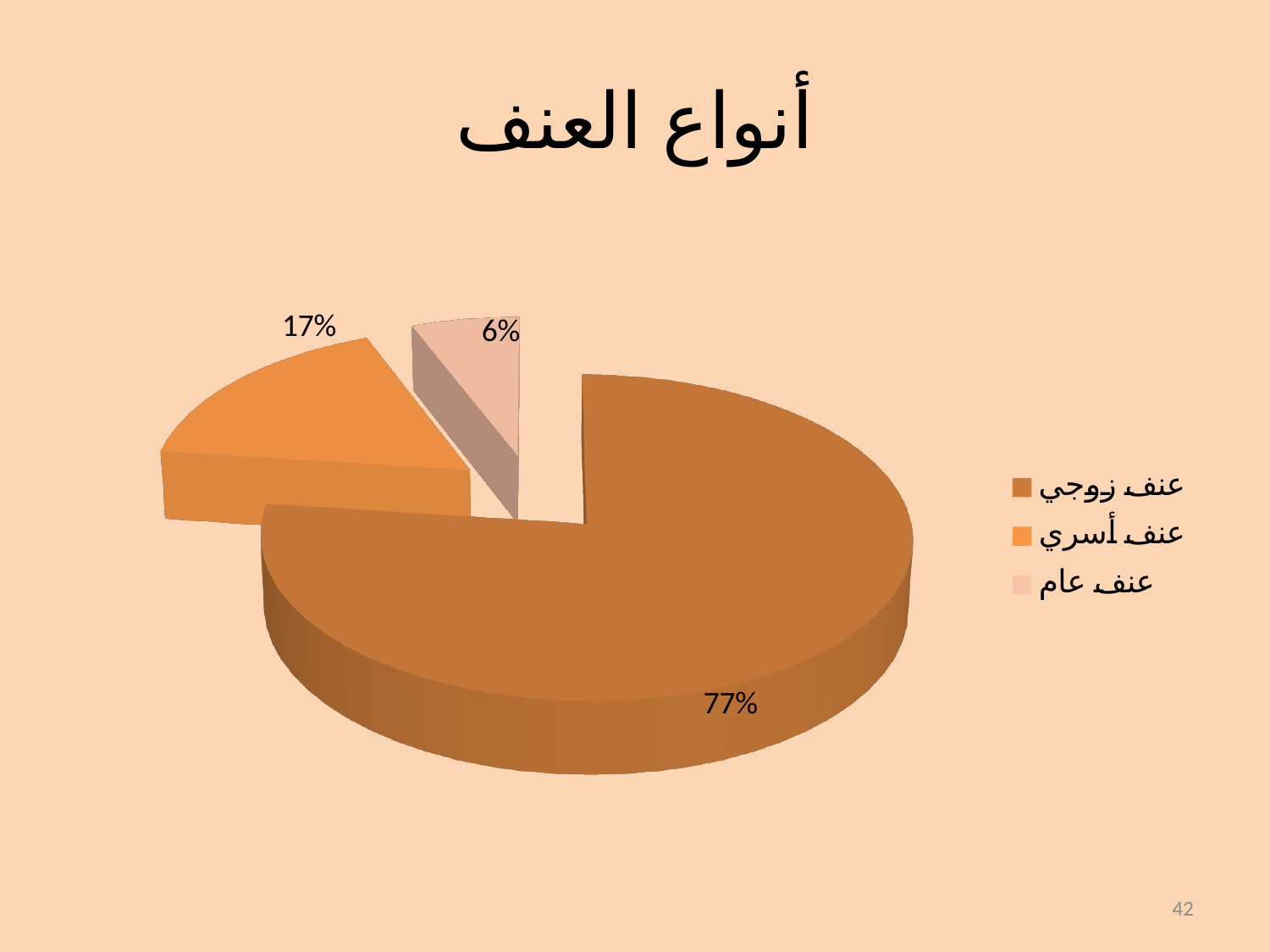
What percentage of the pie is عنف زوجي? 77% How many entries does the legend list? 3 What percentage of the pie is عنف عام? 6% What type of chart is shown on the slide? Pie chart Which is larger, the share for عنف أسري or the share for عنف عام? عنف أسري What is the difference in percentage points between عنف أسري and عنف عام? 11 How many categories does the pie chart show? 3 What is the difference in percentage points between عنف زوجي and عنف أسري? 60 Which category has the largest share of the pie? عنف زوجي What percentage of the pie is عنف أسري? 17% Which category has the smallest share of the pie? عنف عام What is the title of the chart? أنواع العنف